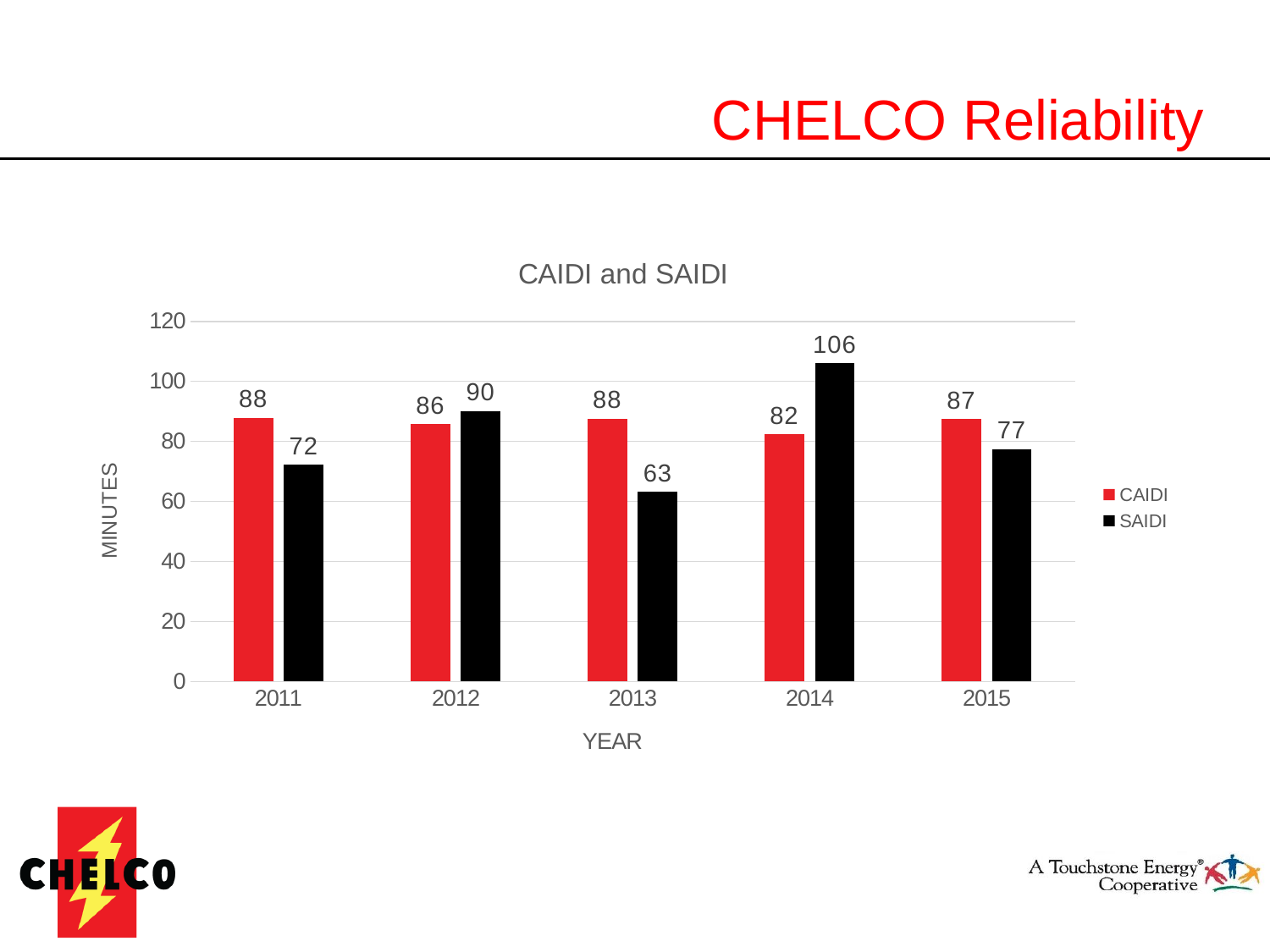
In which year is SAIDI lowest? 2013 What kind of chart is shown? Bar chart How many years are shown on the x axis? 5 What is the difference between SAIDI and CAIDI in 2014? 24 In which year is CAIDI lowest? 2014 What is the title of the chart? CAIDI and SAIDI Which is larger in 2012, CAIDI or SAIDI? SAIDI What is the SAIDI value for 2014? 106 How many series does the legend list? 2 What is the CAIDI value for 2011? 88 In which year is SAIDI highest? 2014 What is the SAIDI value for 2013? 63